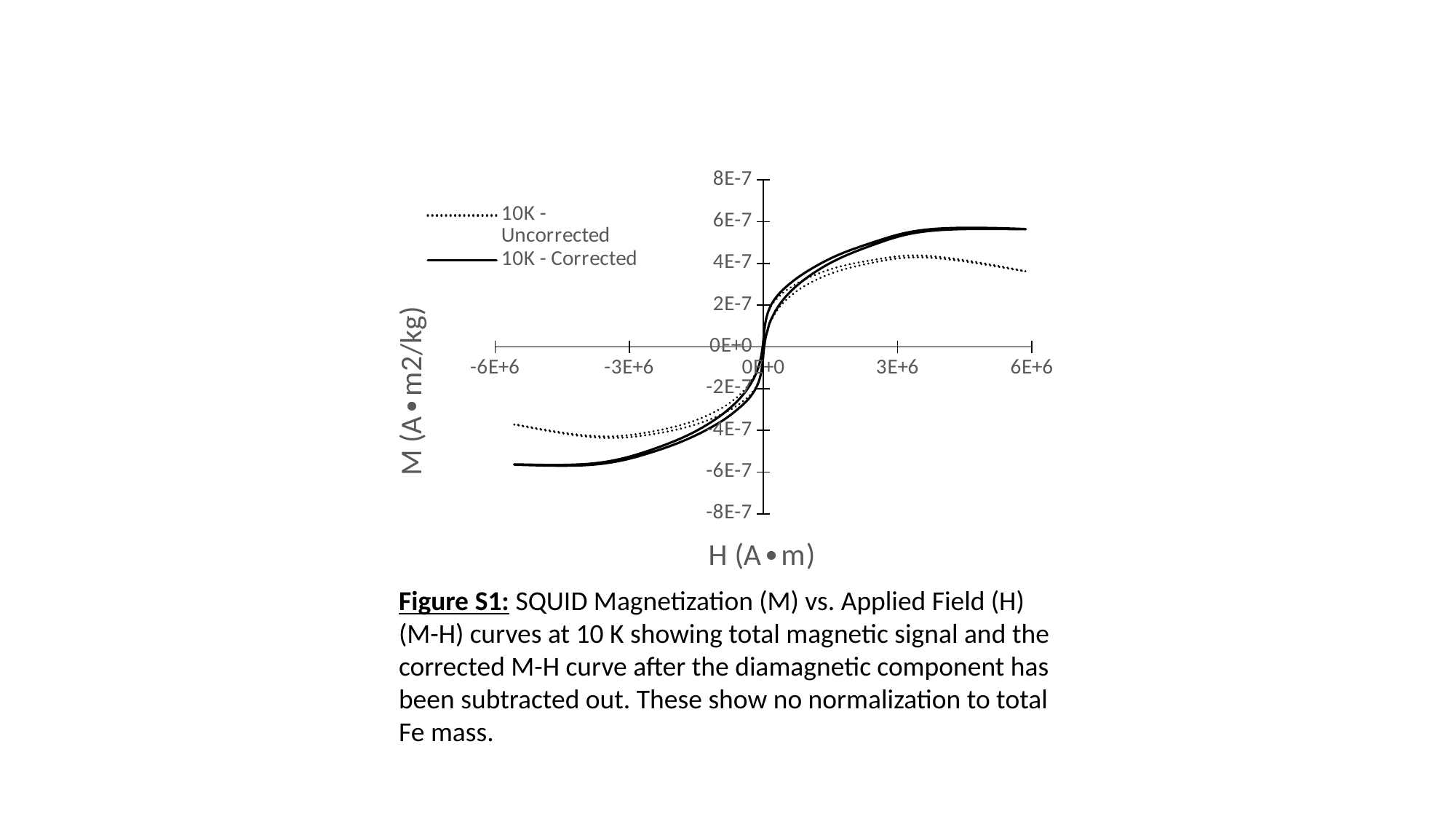
At H = 6E+6, which series has the larger value, 10K - Corrected or 10K - Uncorrected? 10K - Corrected What is the highest tick value shown on the vertical axis? 8E-7 Is the value of the 10K - Uncorrected series at H = -6E+6 greater or less than -6E-7? greater Is the value of the 10K - Uncorrected series at H = 6E+6 greater or less than 4E-7? less Is the value of the 10K - Corrected series at H = 6E+6 greater or less than 4E-7? greater How many series does the legend list? 2 Does the 10K - Uncorrected series rise or fall as H goes from 3E+6 to 6E+6? fall What kind of chart is shown on the slide? Line chart What is the label of the vertical axis? M (A•m2/kg) Which series is drawn with a dotted line? 10K - Uncorrected Does the 10K - Corrected series rise or fall as H goes from 0E+0 to 3E+6? rise